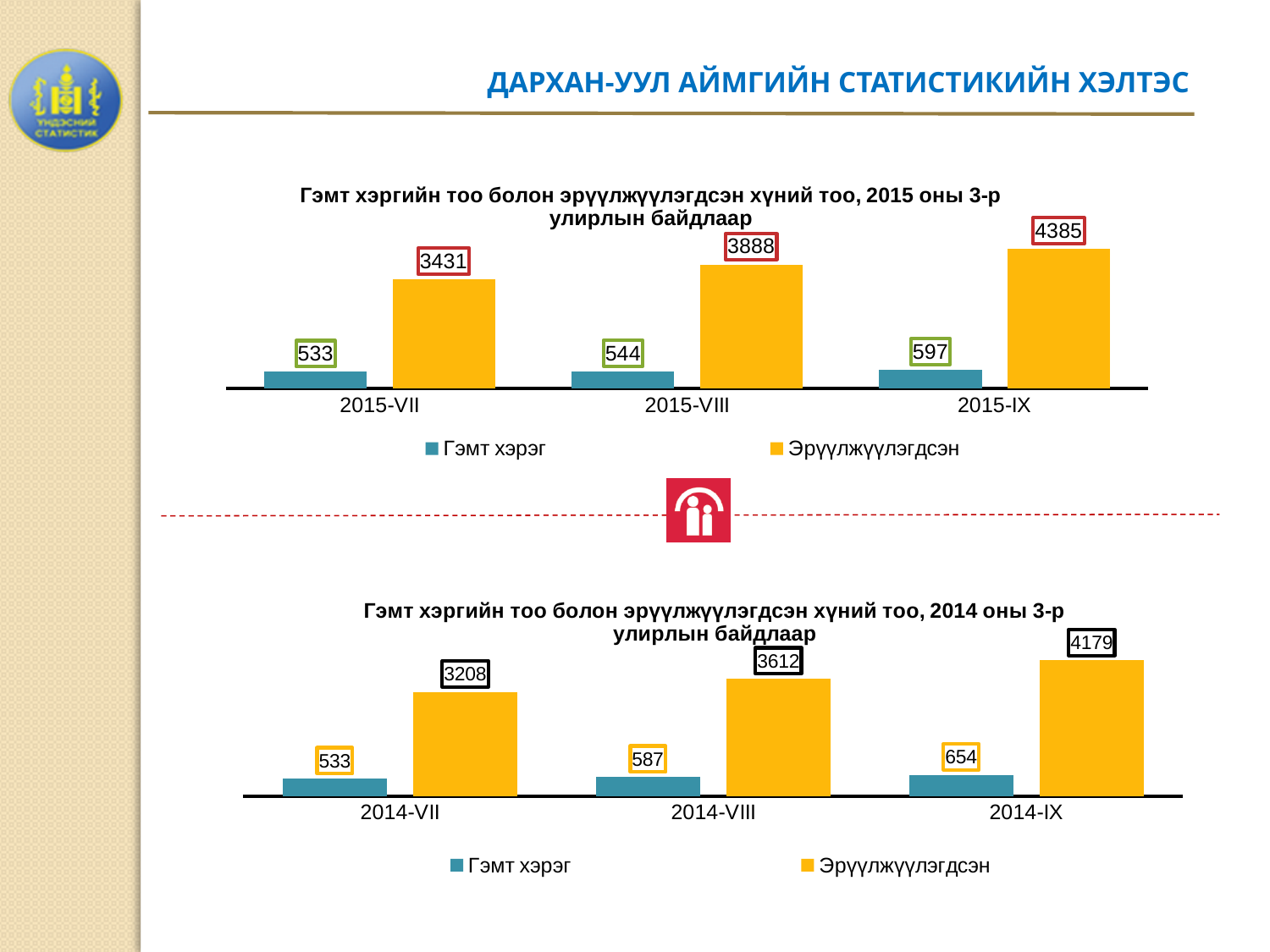
How many series does the legend of the top chart (2015) list? 2 In the bottom chart (2014), which is larger: Эрүүлжүүлэгдсэн for 2014-VIII or for 2014-IX? 2014-IX In the top chart (2015), what is the value of Гэмт хэрэг for 2015-VIII? 544 In the top chart (2015), what is the difference between the Эрүүлжүүлэгдсэн values for 2015-IX and 2015-VII? 954 In the bottom chart (2014), which month has the lowest Гэмт хэрэг value? 2014-VII In the bottom chart (2014), what is the difference between the Гэмт хэрэг values for 2014-IX and 2014-VIII? 67 In the bottom chart (2014), what is the value of Гэмт хэрэг for 2014-IX? 654 In the bottom chart (2014), what is the value of Эрүүлжүүлэгдсэн for 2014-VII? 3208 What kind of chart is the bottom chart (2014)? Bar chart In the top chart (2015), what is the value of Эрүүлжүүлэгдсэн for 2015-IX? 4385 In the top chart (2015), which month has the highest Эрүүлжүүлэгдсэн value? 2015-IX In the top chart (2015), do the Гэмт хэрэг values rise or fall from 2015-VII to 2015-IX? Rise